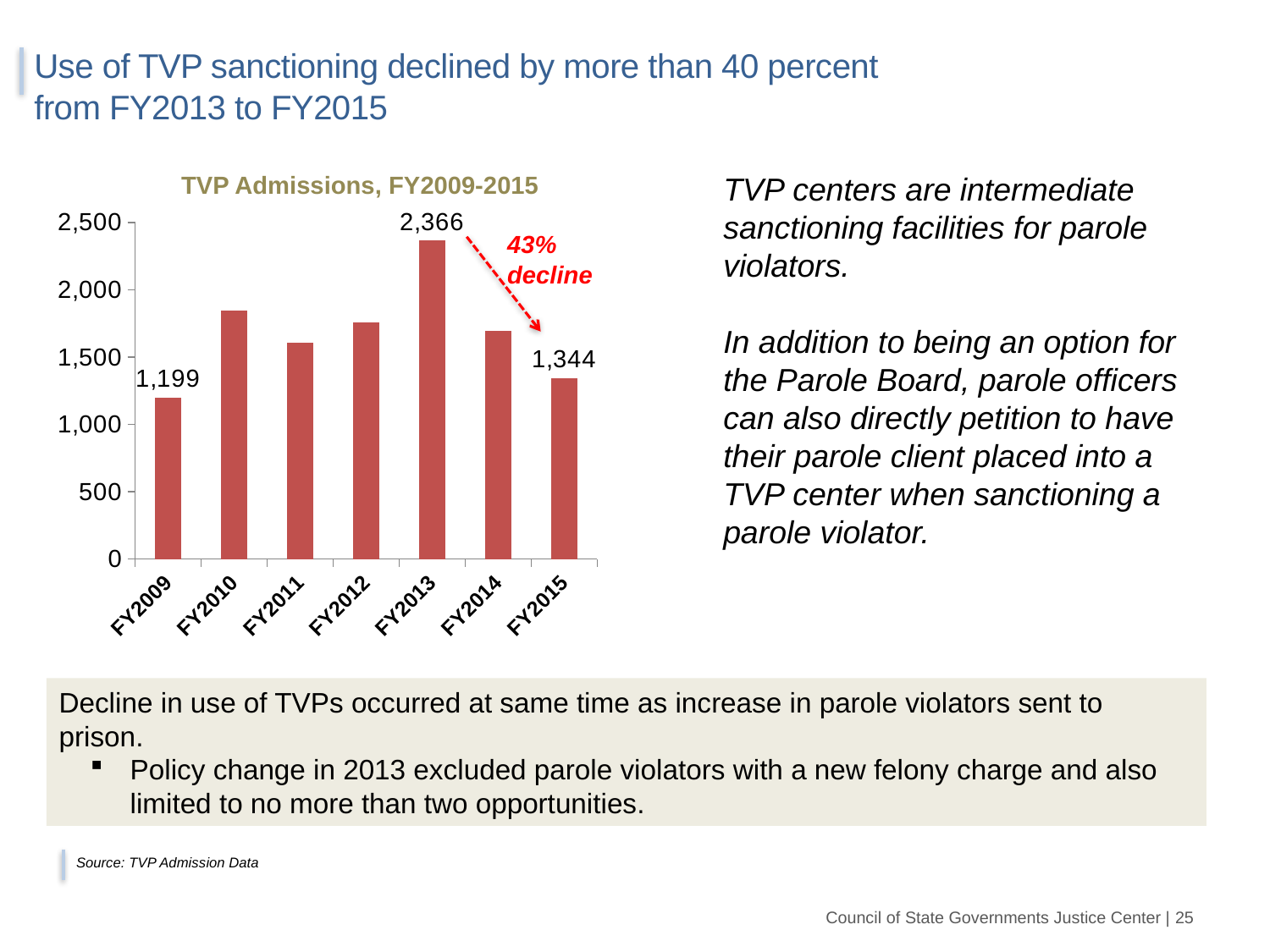
Is the value for FY2010 greater or less than 1,500? greater Which fiscal year has the highest TVP admissions? FY2013 How many fiscal years are shown in the TVP Admissions chart? 7 What is the value for FY2015 in the TVP Admissions chart? 1,344 What kind of chart is used to show TVP Admissions? Bar chart What is the difference between TVP admissions in FY2013 and FY2015? 1,022 What is the value for FY2013 in the TVP Admissions chart? 2,366 What is the value for FY2009 in the TVP Admissions chart? 1,199 What percentage decline is annotated on the chart between FY2013 and FY2015? 43% decline Is the value for FY2014 greater or less than 2,000? less Which fiscal year has the lowest TVP admissions? FY2009 Which is larger, TVP admissions in FY2009 or in FY2015? FY2015